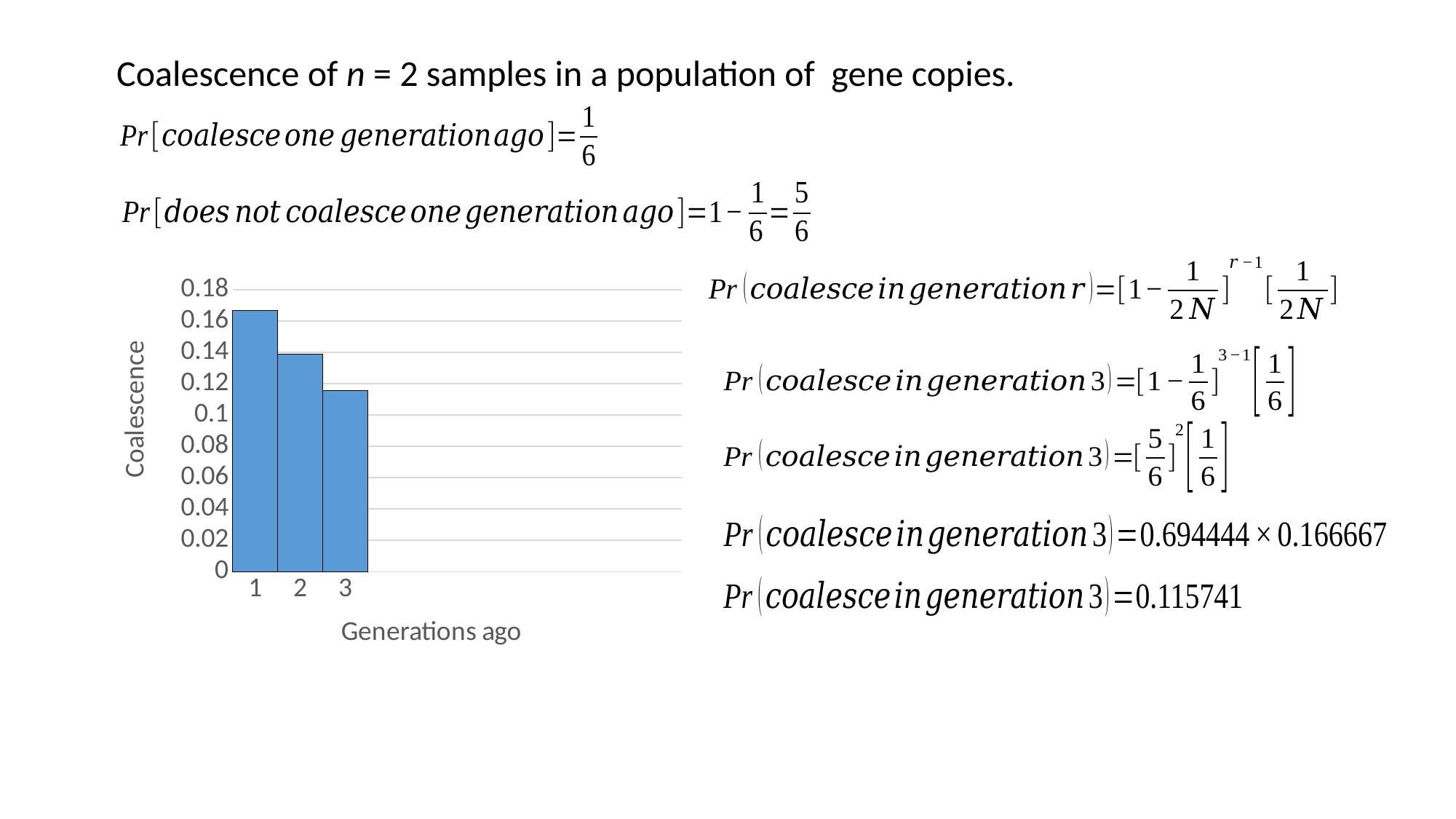
Is the Coalescence value for 3 generations ago greater or less than 0.1? greater Which value of Generations ago has the highest Coalescence bar? 1 Which bar is taller: 1 generation ago or 3 generations ago? 1 generation ago Do the bar heights rise or fall as Generations ago increases from 1 to 3? fall What is the label of the horizontal axis of the chart? Generations ago Which value of Generations ago has the lowest Coalescence bar? 3 How many bars are plotted in the chart? 3 Is the Coalescence value for 3 generations ago greater or less than 0.14? less What kind of chart is shown on the slide? bar chart Is the Coalescence value for 1 generation ago greater or less than 0.14? greater What is the label of the vertical axis of the chart? Coalescence